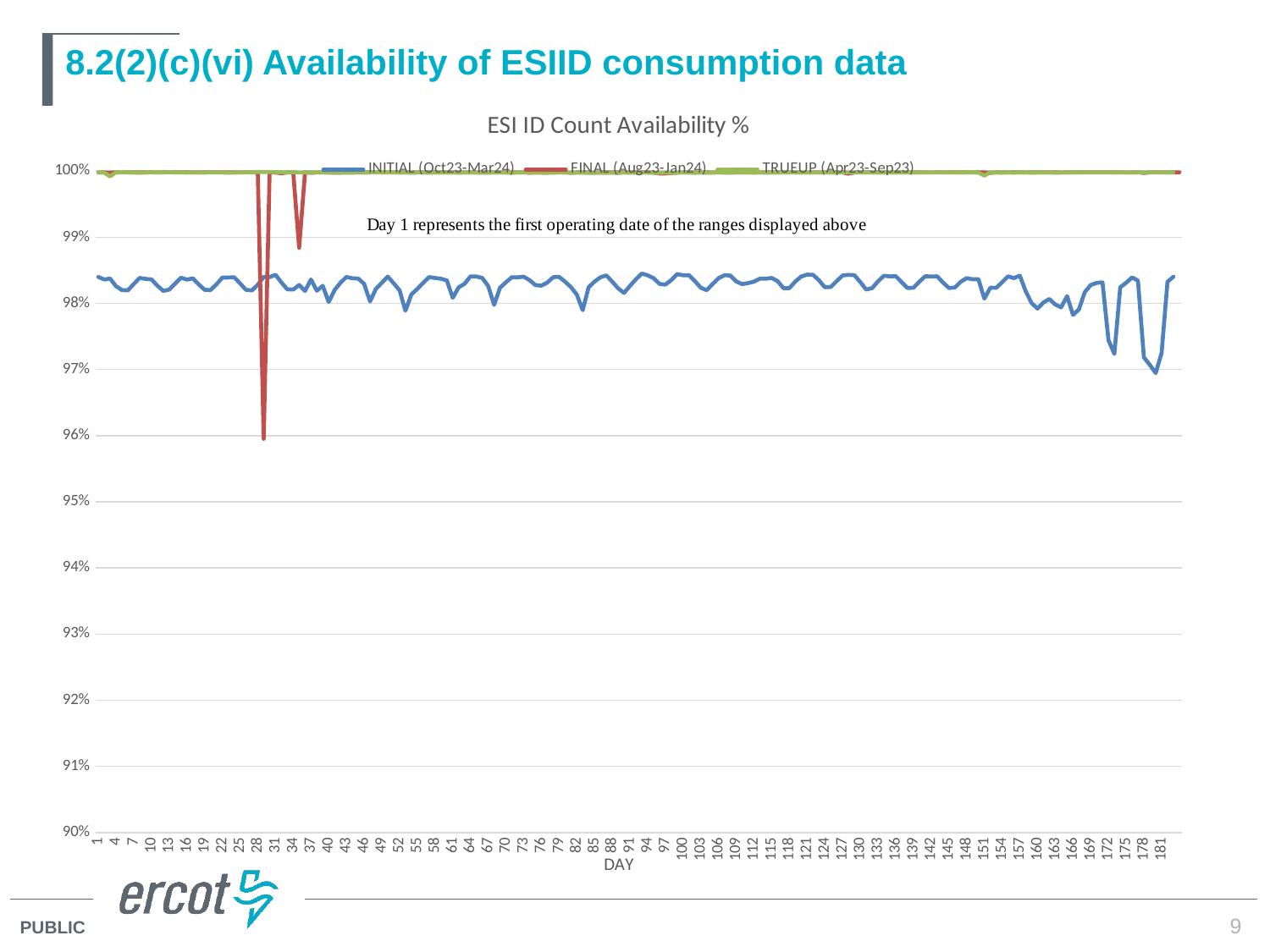
How many series does the legend of the chart list? 3 What is the label of the x axis of the chart? DAY Is the value of the INITIAL (Oct23-Mar24) series at day 100 greater or less than 99%? less Is the lowest point of the FINAL (Aug23-Jan24) series greater or less than 97%? less What is the title of the chart? ESI ID Count Availability % Is the value of the INITIAL (Oct23-Mar24) series at day 100 greater or less than 97%? greater Which series stays closest to 100% across all days? TRUEUP (Apr23-Sep23) What kind of chart is shown on the slide? Line chart Which series has the lowest values for most of the days shown? INITIAL (Oct23-Mar24) Around day 100, which series is higher: INITIAL (Oct23-Mar24) or FINAL (Aug23-Jan24)? FINAL (Aug23-Jan24) Does the INITIAL (Oct23-Mar24) series rise or fall over the last days of the range (around days 160 to 180) compared with its level around day 100? fall